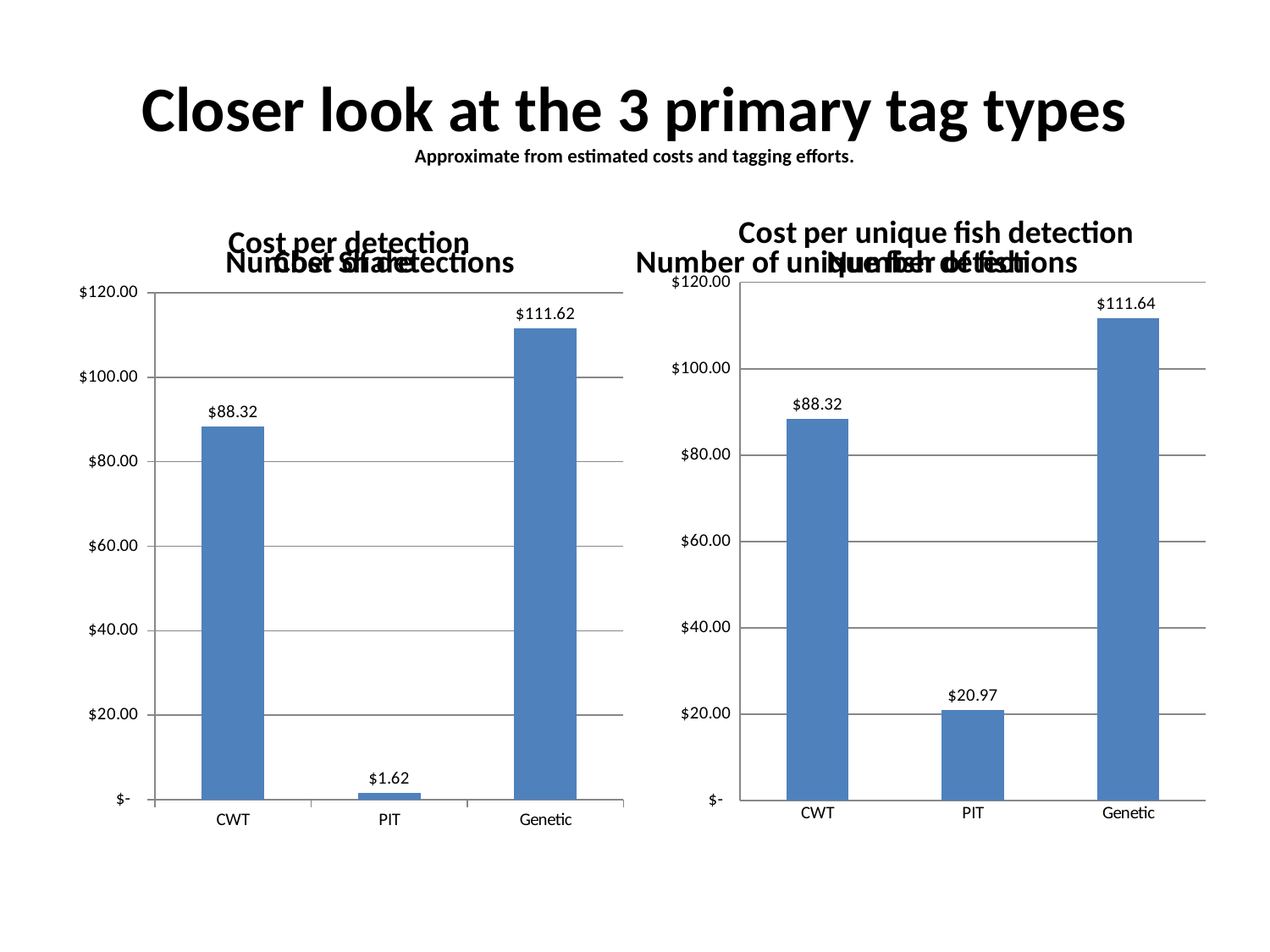
In the right chart, what is the value for PIT? $20.97 In the right chart, is the value for CWT greater or less than $80.00? greater In the left chart, what is the value for CWT? $88.32 In the left chart, what is the value for PIT? $1.62 In the left chart, what is the difference between the values for Genetic and CWT? $23.30 In the left chart, which is larger, the value for CWT or the value for Genetic? Genetic In the left chart, which category has the highest value? Genetic What kind of chart is the left chart? Bar chart In the right chart, what is the value for Genetic? $111.64 How many categories are shown on the x axis of the right chart? 3 In the right chart, which category has the lowest value? PIT In the right chart, what is the difference between the values for Genetic and PIT? $90.67